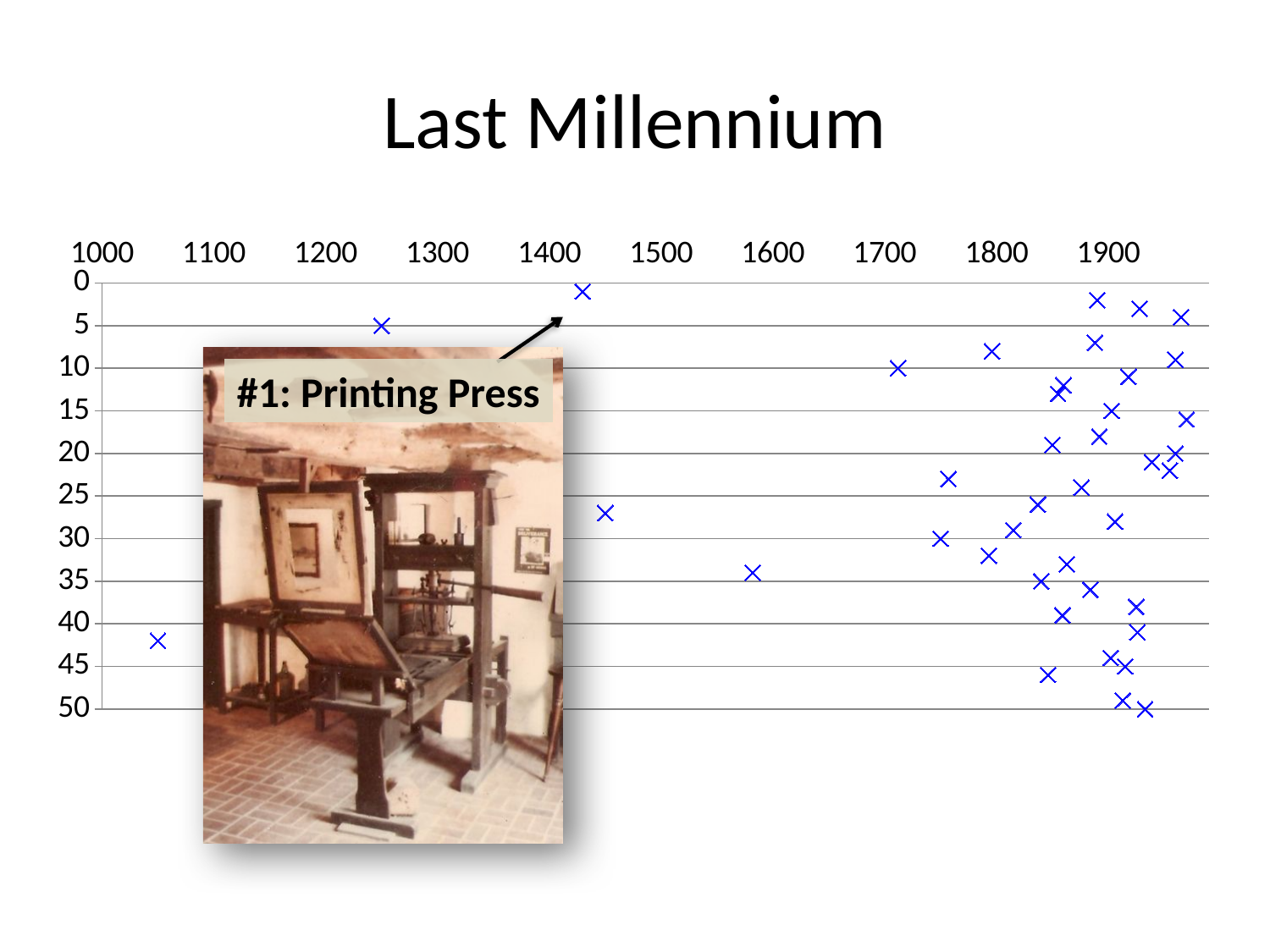
Is the y value of the point plotted near the year 1700 greater or less than 20? less What kind of chart is shown on the slide? scatter chart Which has the smaller y value: the point plotted near 1250 or the point plotted near 1450 at about rank 27? the point near 1250 What rank value does the point annotated as the Printing Press have? 1 Is the y value of the point plotted near the year 1050 greater or less than 35? greater Is the y value of the point plotted near the year 1600 greater or less than 30? greater Which point has the lowest y-axis value on the chart? #1: Printing Press What does the annotation label on the chart say? #1: Printing Press What is the title of the chart? Last Millennium